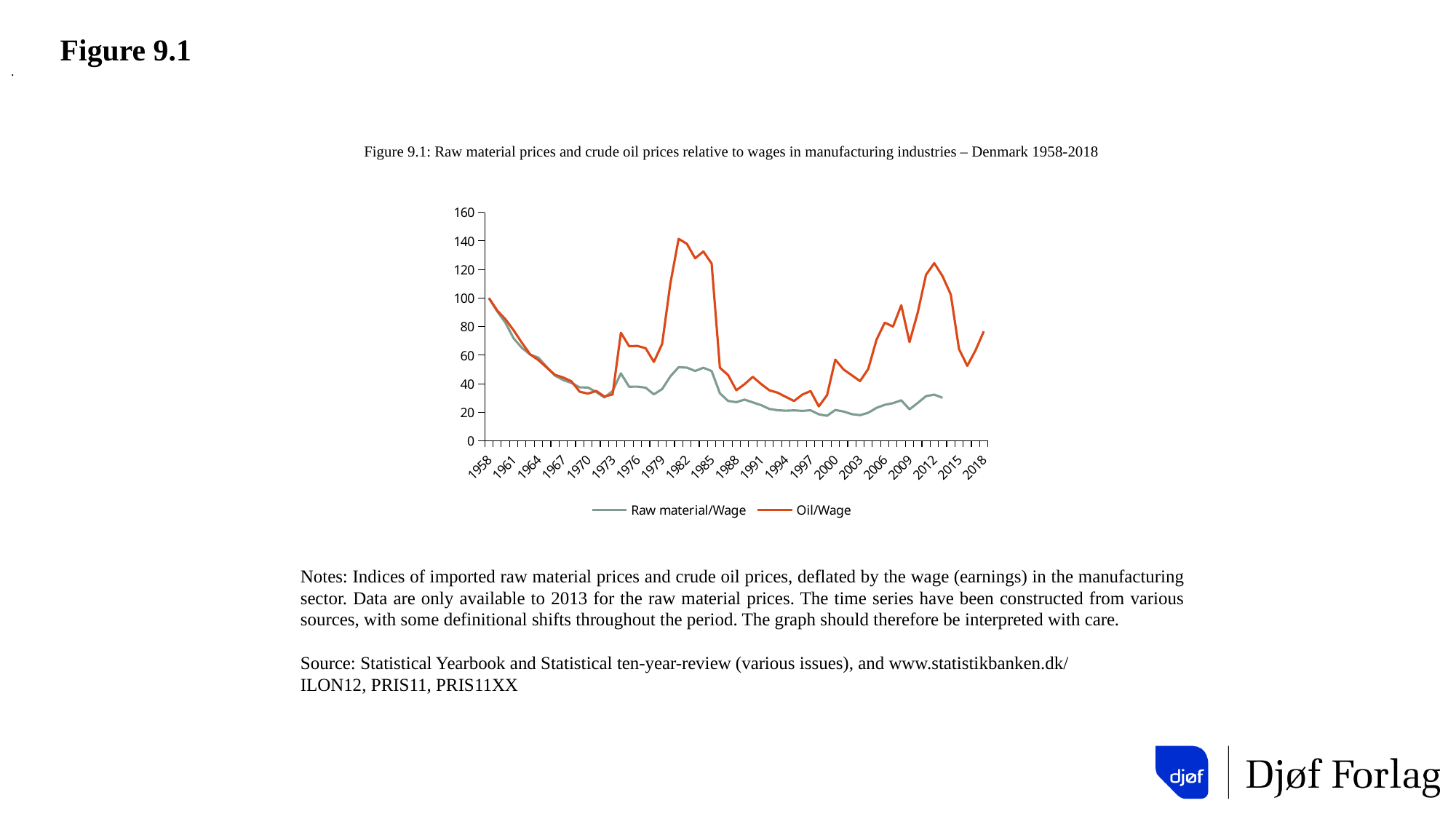
Is the value for Oil/Wage in 2012 greater or less than 100? greater Is the value for Oil/Wage in 1982 greater or less than 120? greater How many series does the legend list? 2 Is the value for Raw material/Wage in 1982 greater or less than 60? less Does the Oil/Wage series rise or fall between 1985 and 1988? fall Which series is drawn in orange-red? Oil/Wage Does the Raw material/Wage series rise or fall between 1958 and 1970? fall Which series has the higher value in 1982, Raw material/Wage or Oil/Wage? Oil/Wage What is the value of Oil/Wage in 1958? 100 What is the value of Raw material/Wage in 1958? 100 What kind of chart is shown in Figure 9.1? line chart